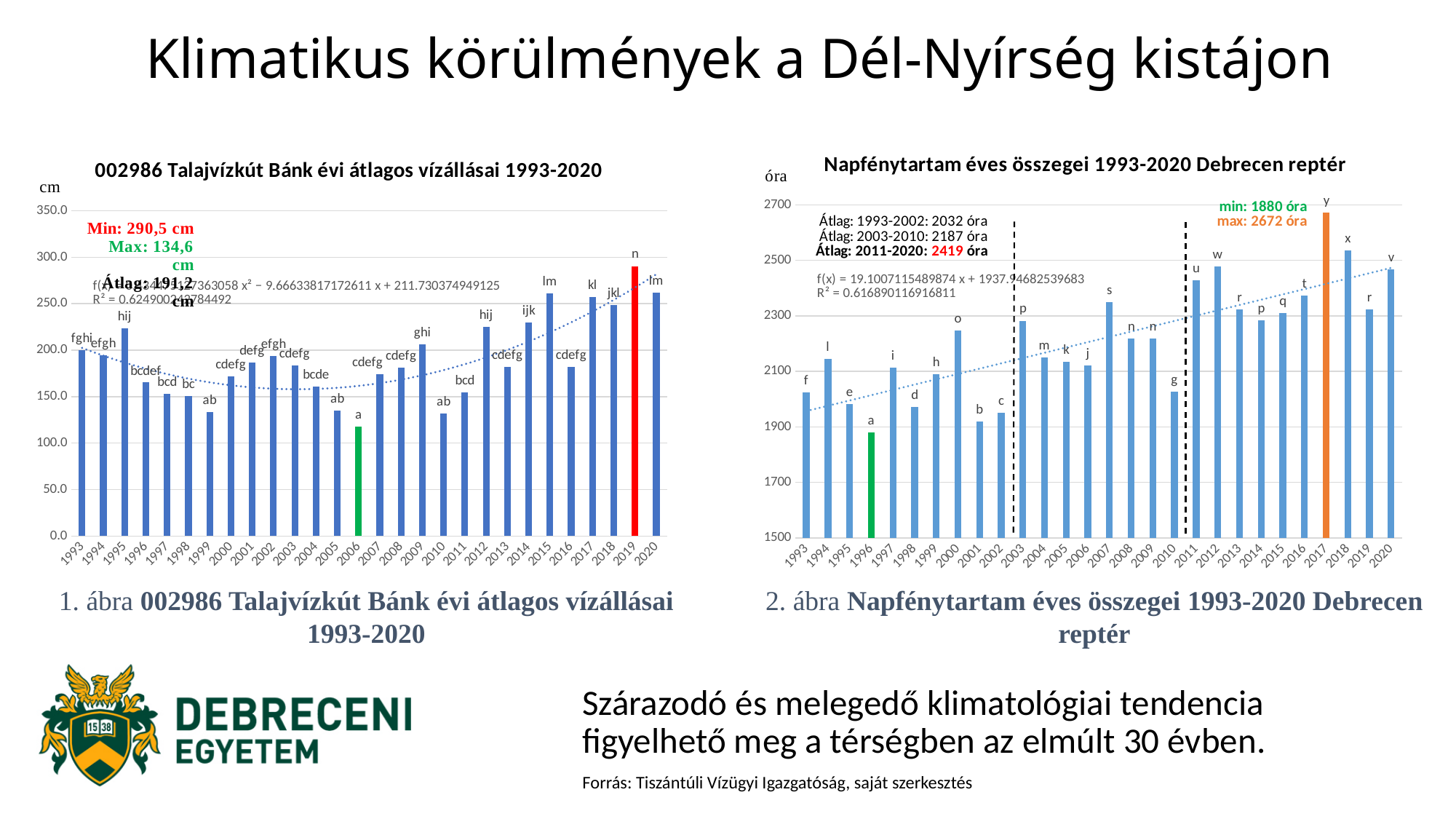
On the right chart 'Napfénytartam éves összegei', what is the printed average (Átlag) for 2003-2010? 2187 óra How many years (bars) are plotted on the right chart, 'Napfénytartam éves összegei 1993-2020 Debrecen reptér'? 28 On the right chart 'Napfénytartam éves összegei', do the values generally rise or fall from 1993 to 2020? rise On the right chart 'Napfénytartam éves összegei', what is the maximum value printed on the chart? 2672 óra On the left chart 'Talajvízkút Bánk', which year has the tallest bar? 2019 On the right chart 'Napfénytartam éves összegei', what is the difference between the printed max and min values? 792 óra On the right chart 'Napfénytartam éves összegei', which year has the highest value? 2017 On the left chart 'Talajvízkút Bánk', is the value for 2010 greater or less than 150? less On the right chart 'Napfénytartam éves összegei', is the value for 2007 greater or less than 2300? greater On the left chart 'Talajvízkút Bánk', what is the printed average (Átlag) value? 191,2 cm What kind of chart is the left chart, '002986 Talajvízkút Bánk évi átlagos vízállásai 1993-2020'? bar chart On the right chart 'Napfénytartam éves összegei', which year has the lowest value? 1996